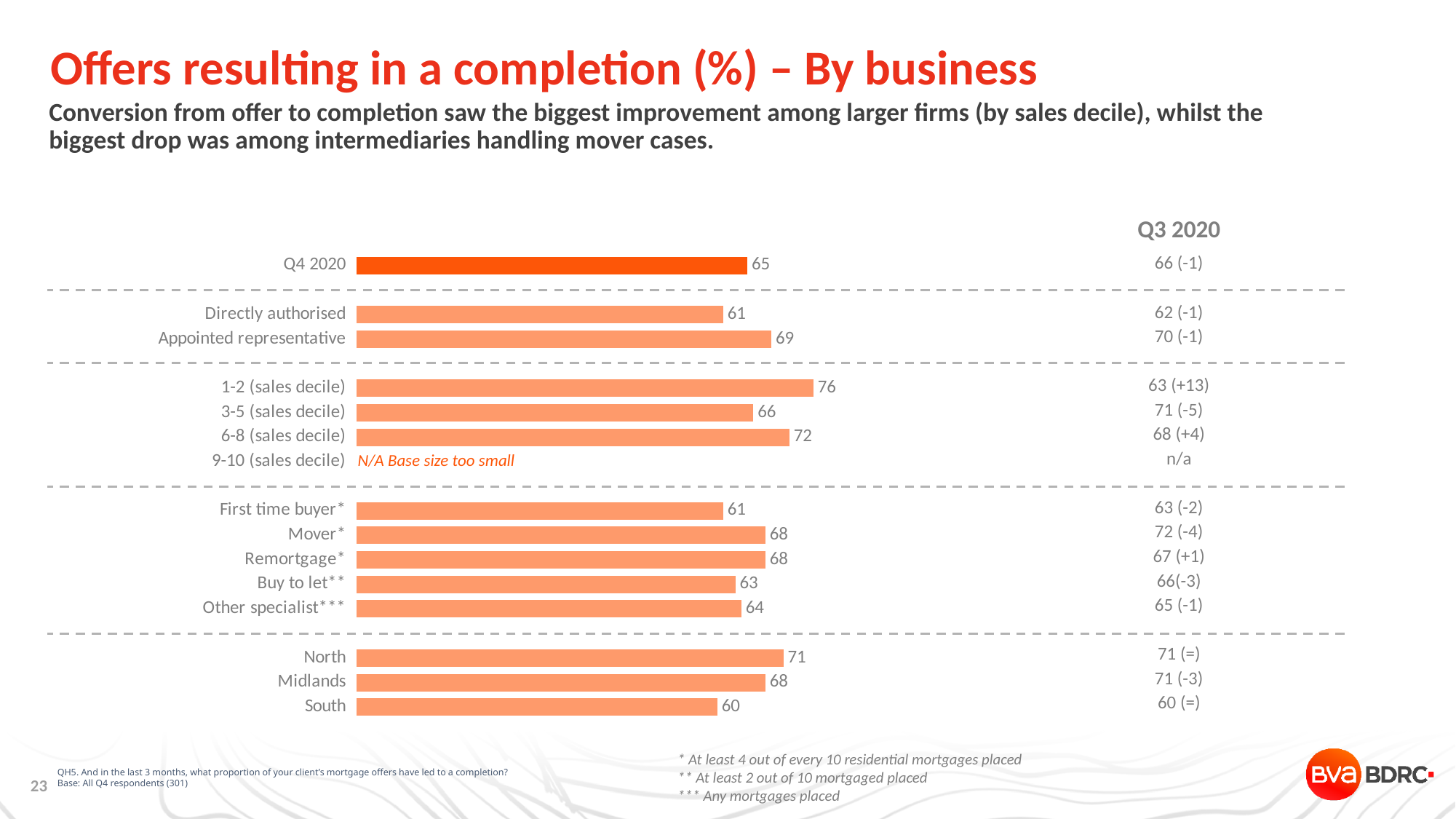
What is the value for South? 60 What kind of chart is shown on the slide? Bar chart What is the value for 6-8 (sales decile)? 72 What is the value for Q4 2020 overall? 65 What is the value for Appointed representative? 69 How many regions (North, Midlands, South) are shown in the bottom group of the chart? 3 What is the difference between the values for North and South? 11 Which category has the lowest value? South Which category has the highest value? 1-2 (sales decile) What is shown for 9-10 (sales decile) instead of a bar? N/A Base size too small Which is larger, the value for Directly authorised or Appointed representative? Appointed representative What is the difference between the values for 1-2 (sales decile) and 3-5 (sales decile)? 10